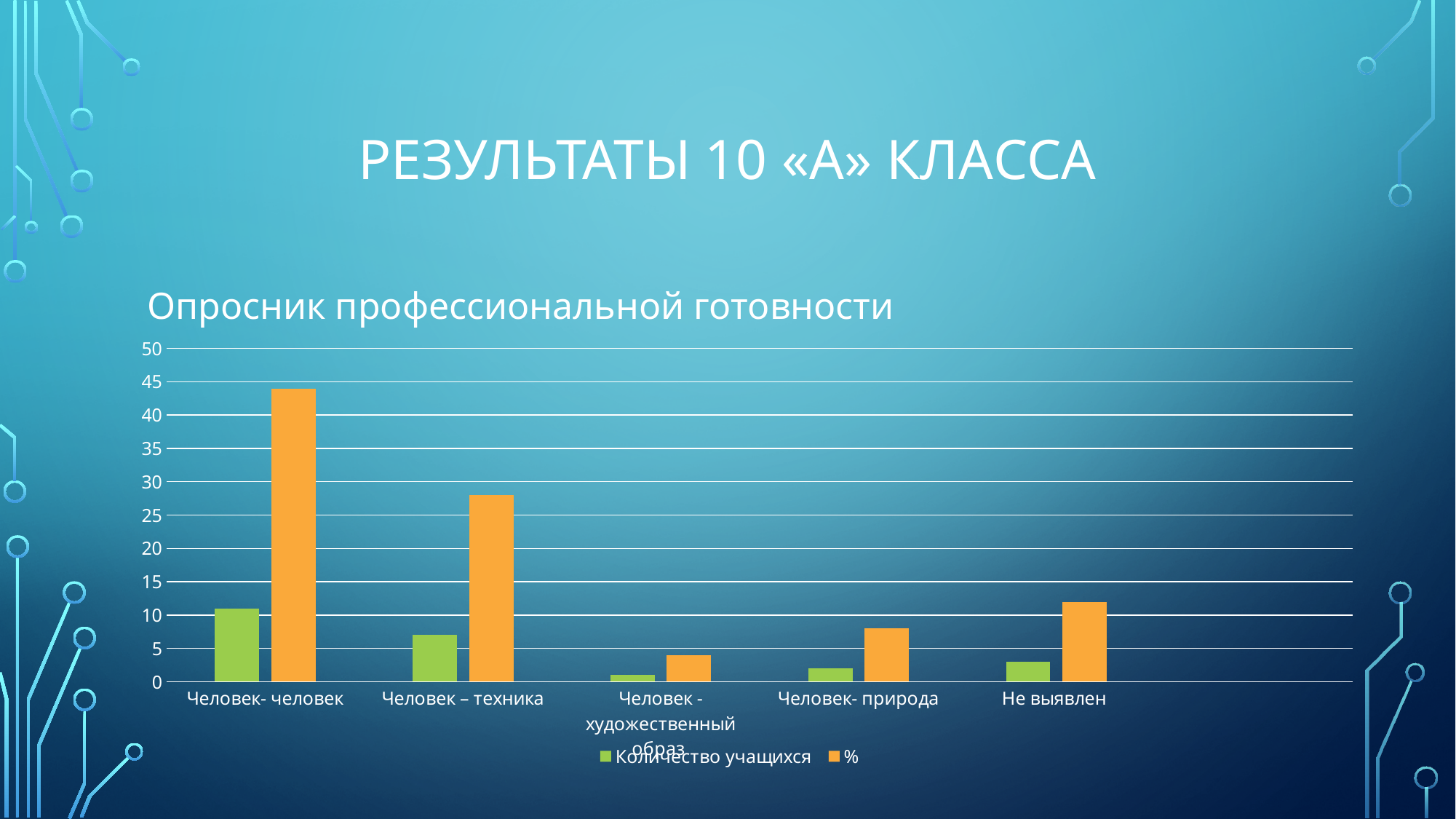
How many series does the chart legend list? 2 What kind of chart is shown on the slide? bar chart Which category has the highest value for the % series? Человек- человек Which is larger, the % value for Человек – техника or the % value for Не выявлен? Человек – техника Is the % value for Человек – техника greater or less than 25? greater Is the % value for Человек- природа greater or less than 10? less Is the % value for Человек- человек greater or less than 40? greater Which series is shown in orange in the chart? % Which category has the lowest value for the % series? Человек - художественный образ How many categories are shown on the x axis of the chart? 5 Which category has the highest value for Количество учащихся? Человек- человек What is the title of the chart? Опросник профессиональной готовности